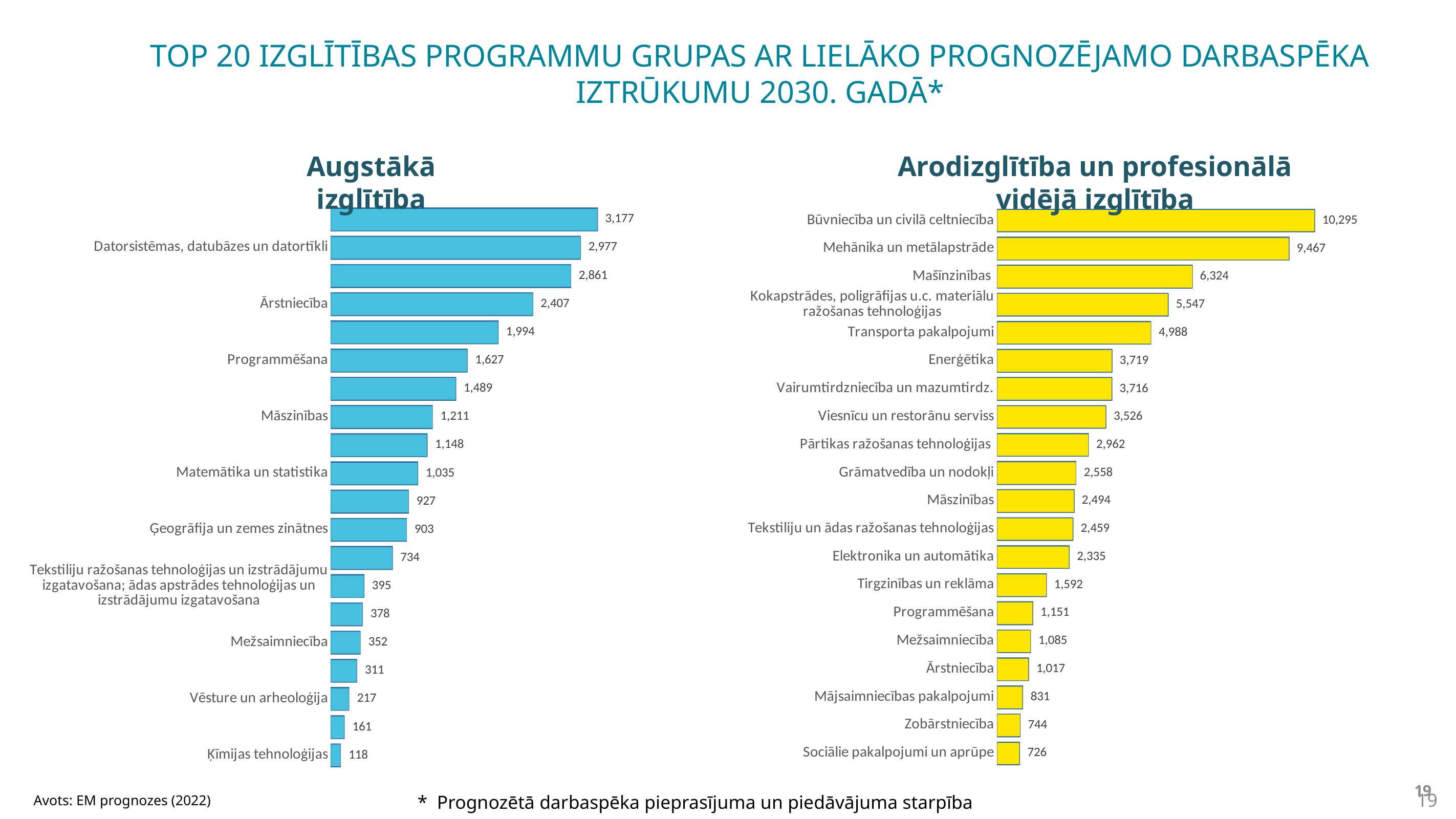
In the 'Augstākā izglītība' chart, what is the value for Programmēšana? 1,627 In the 'Arodizglītība un profesionālā vidējā izglītība' chart, which category has the lowest value? Sociālie pakalpojumi un aprūpe In the 'Arodizglītība un profesionālā vidējā izglītība' chart, what is the value for Būvniecība un civilā celtniecība? 10,295 What type of chart is the 'Augstākā izglītība' chart? Bar chart Which is larger: Māszinības in the 'Augstākā izglītība' chart or Māszinības in the 'Arodizglītība un profesionālā vidējā izglītība' chart? Arodizglītība un profesionālā vidējā izglītība How many bars does the 'Arodizglītība un profesionālā vidējā izglītība' chart show? 20 In the 'Arodizglītība un profesionālā vidējā izglītība' chart, what is the value for Transporta pakalpojumi? 4,988 In the 'Arodizglītība un profesionālā vidējā izglītība' chart, which category has the highest value? Būvniecība un civilā celtniecība In the 'Augstākā izglītība' chart, which labelled category has the lowest value? Ķīmijas tehnoloģijas In the 'Arodizglītība un profesionālā vidējā izglītība' chart, what is the difference between Mehānika un metālapstrāde and Mašīnzinības? 3,143 In the 'Augstākā izglītība' chart, what is the difference between Datorsistēmas, datubāzes un datortīkli and Ārstniecība? 570 In the 'Augstākā izglītība' chart, what is the value for Ārstniecība? 2,407